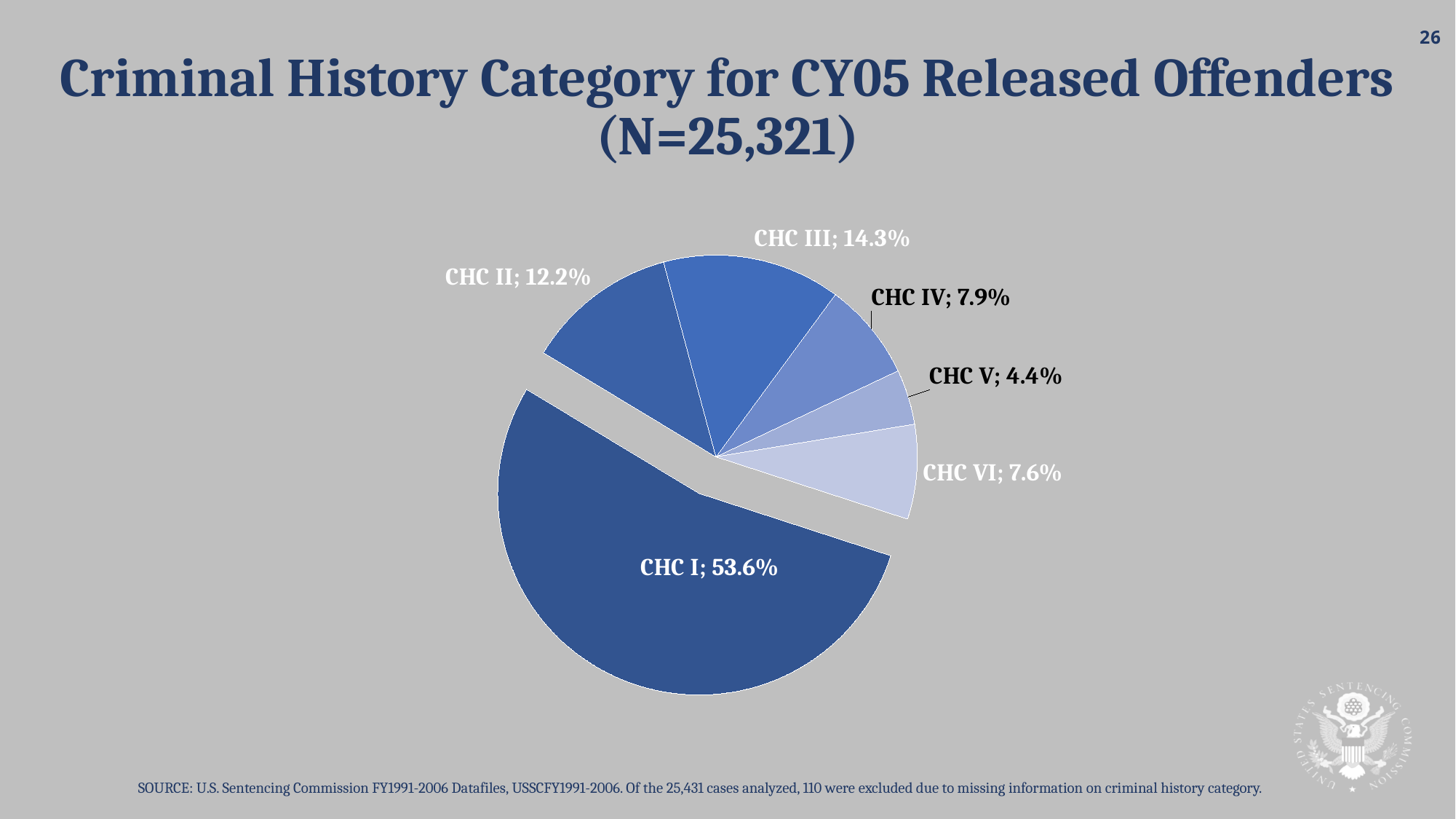
What percentage of CY05 released offenders were in CHC VI? 7.6% What is the combined percentage of CHC IV and CHC V? 12.3% What is the N value given in the chart title? 25,321 What percentage of CY05 released offenders were in CHC V? 4.4% How many criminal history categories are shown in the pie chart? 6 Which criminal history category has the largest share of the pie? CHC I What type of chart is shown on the slide? pie chart What percentage of CY05 released offenders were in CHC III? 14.3% Which criminal history category has the smallest share of the pie? CHC V Which is larger, the share for CHC IV or the share for CHC VI? CHC IV What is the difference in percentage points between CHC II and CHC III? 2.1 What percentage of CY05 released offenders were in CHC I? 53.6%